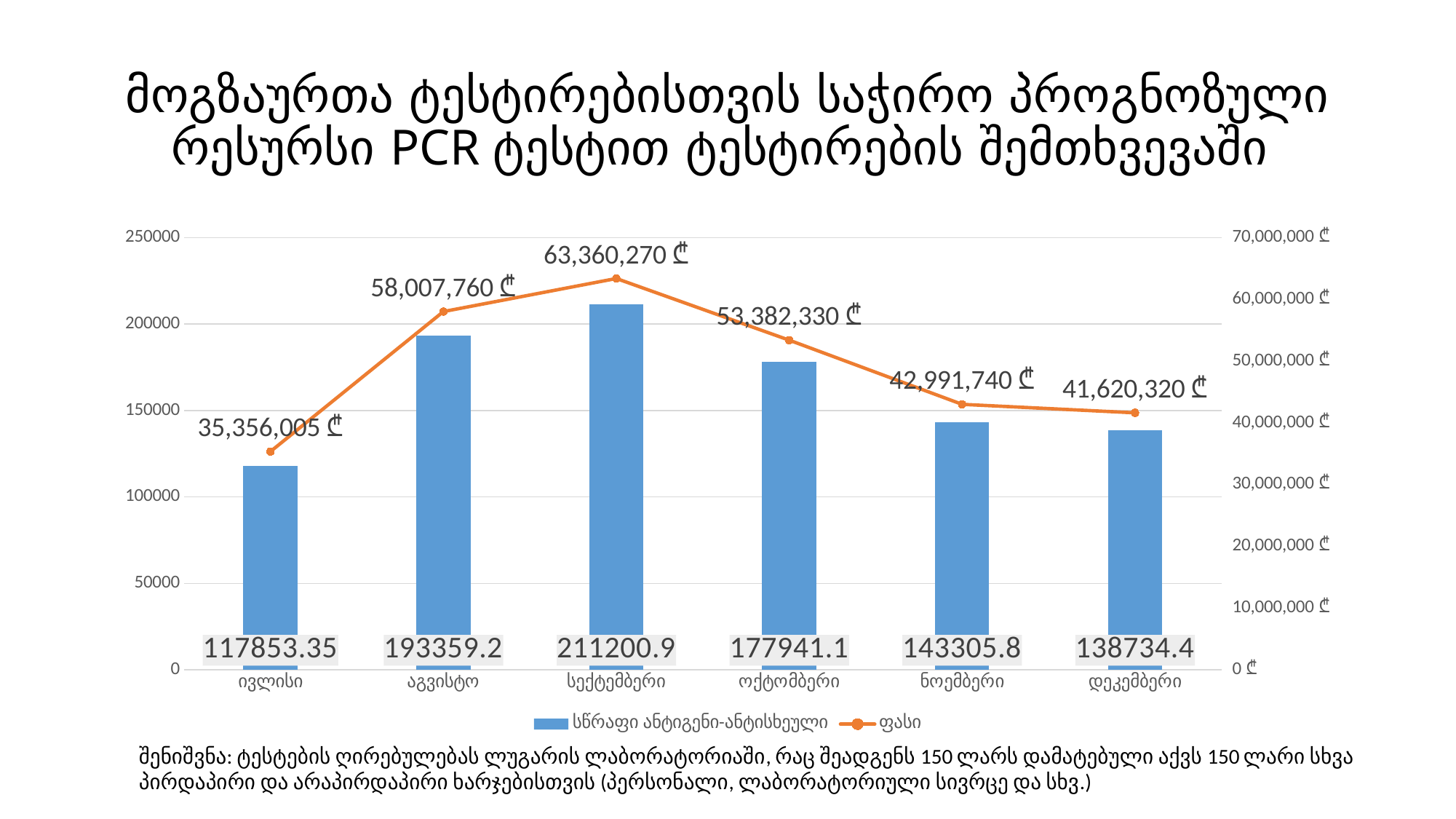
What is the ფასი value shown for ნოემბერი? 42,991,740 ₾ Which month has the highest სწრაფი ანტიგენი-ანტისხეული bar? სექტემბერი What kind of chart is shown on the slide? Combined bar and line chart What is the value of the სწრაფი ანტიგენი-ანტისხეული bar for სექტემბერი? 211200.9 How many series does the legend list? 2 From სექტემბერი to დეკემბერი, do the ფასი values rise or fall? Fall What is the difference between the სწრაფი ანტიგენი-ანტისხეული values for სექტემბერი and აგვისტო? 17841.7 What is the difference between the ფასი values for ნოემბერი and დეკემბერი? 1,371,420 ₾ Which month has the lowest ფასი value? ივლისი What is the ფასი value shown for ივლისი? 35,356,005 ₾ How many months are shown on the x axis? 6 Which is larger, the ფასი value for ოქტომბერი or for აგვისტო? აგვისტო